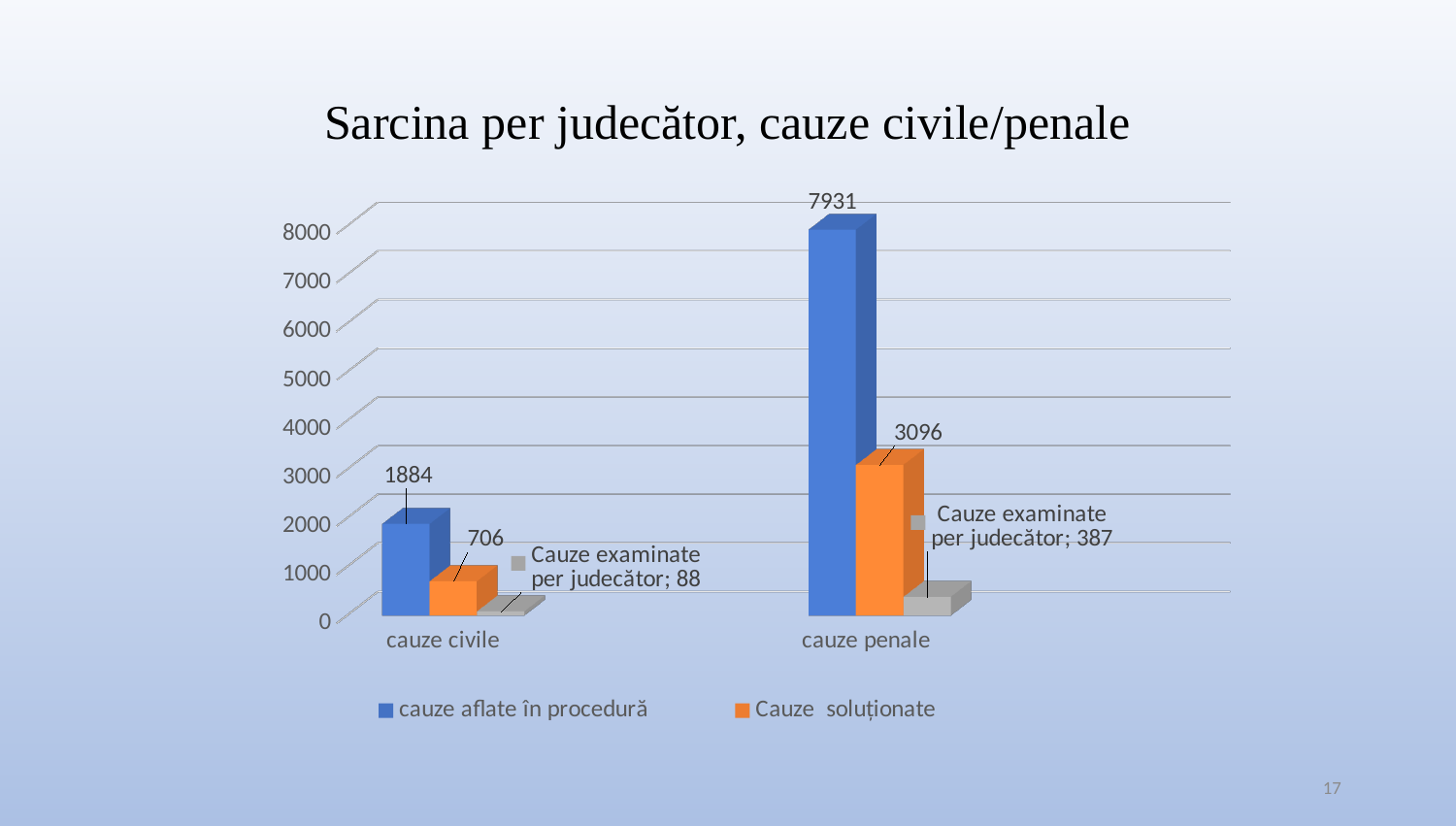
How many series does the legend list? 2 What is the title of the chart? Sarcina per judecător, cauze civile/penale What is the value of Cauze examinate per judecător for cauze civile? 88 Which is larger: Cauze soluționate for cauze civile or Cauze examinate per judecător for cauze penale? Cauze soluționate for cauze civile What is the value of cauze aflate în procedură for cauze civile? 1884 What is the difference between cauze aflate în procedură for cauze penale and for cauze civile? 6047 Which category has the higher value for cauze aflate în procedură? cauze penale What is the value of Cauze examinate per judecător for cauze penale? 387 How many categories are shown on the x axis? 2 What is the difference between cauze aflate în procedură and Cauze soluționate for cauze penale? 4835 What is the value of Cauze soluționate for cauze penale? 3096 What kind of chart is shown on the slide? bar chart